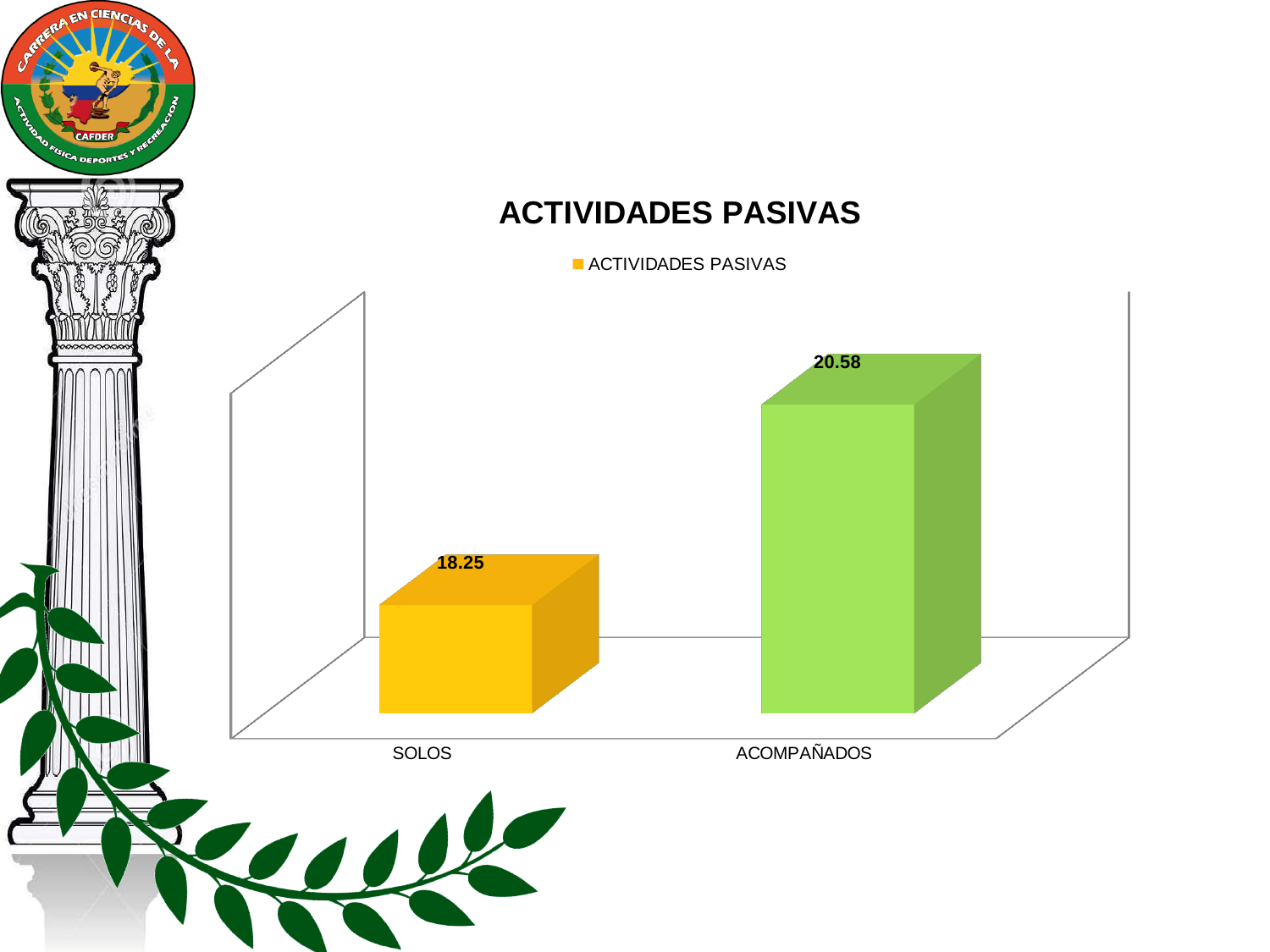
Which category has the lowest value? SOLOS Which is larger, the value for SOLOS or the value for ACOMPAÑADOS? ACOMPAÑADOS What is the difference between the values for ACOMPAÑADOS and SOLOS? 2.33 How many series does the legend list? 1 What is the title of the chart? ACTIVIDADES PASIVAS What kind of chart is shown on the slide? Bar chart What is the value for ACOMPAÑADOS? 20.58 What colour is the bar for SOLOS? Yellow Which category has the highest value? ACOMPAÑADOS How many categories are shown in the chart? 2 What is the value for SOLOS? 18.25